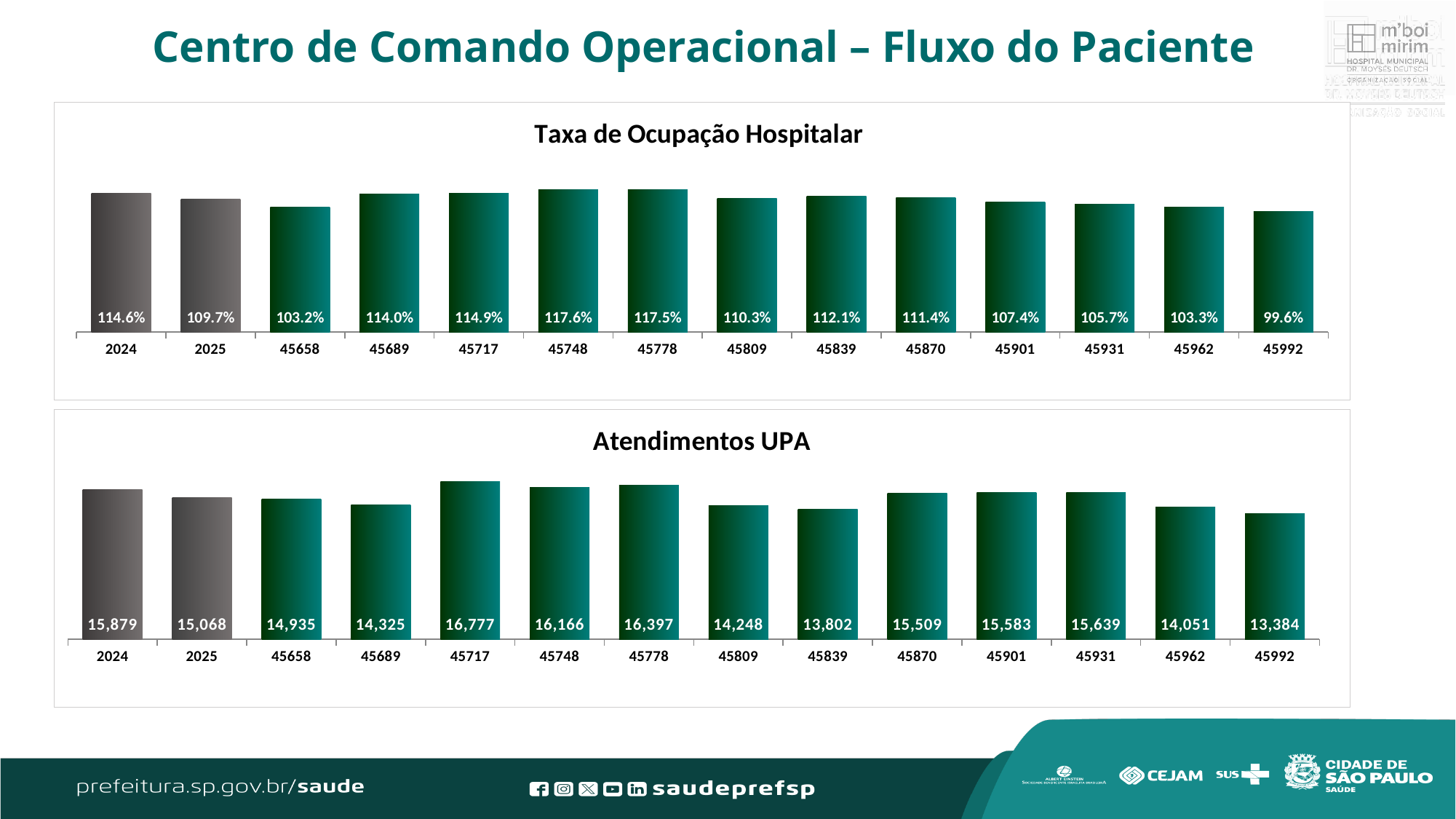
In the 'Taxa de Ocupação Hospitalar' chart, what is the difference between the 2024 and 2025 values? 4.9 percentage points In the 'Taxa de Ocupação Hospitalar' chart, what is the value for 2024? 114.6% In the 'Atendimentos UPA' chart, which category has the highest value? 45717 In the 'Taxa de Ocupação Hospitalar' chart, which category has the lowest value? 45992 In the 'Taxa de Ocupação Hospitalar' chart, which category has the highest value? 45748 In the 'Taxa de Ocupação Hospitalar' chart, what is the value for 45748? 117.6% What type of chart is the 'Atendimentos UPA' chart? Bar chart In the 'Atendimentos UPA' chart, which category has the lowest value? 45992 In the 'Atendimentos UPA' chart, which is larger: the value for 45748 or the value for 45778? 45778 In the 'Atendimentos UPA' chart, what is the value for 2025? 15,068 In the 'Atendimentos UPA' chart, what is the difference between the 2024 and 2025 values? 811 In the 'Taxa de Ocupação Hospitalar' chart, how many bars are plotted? 14